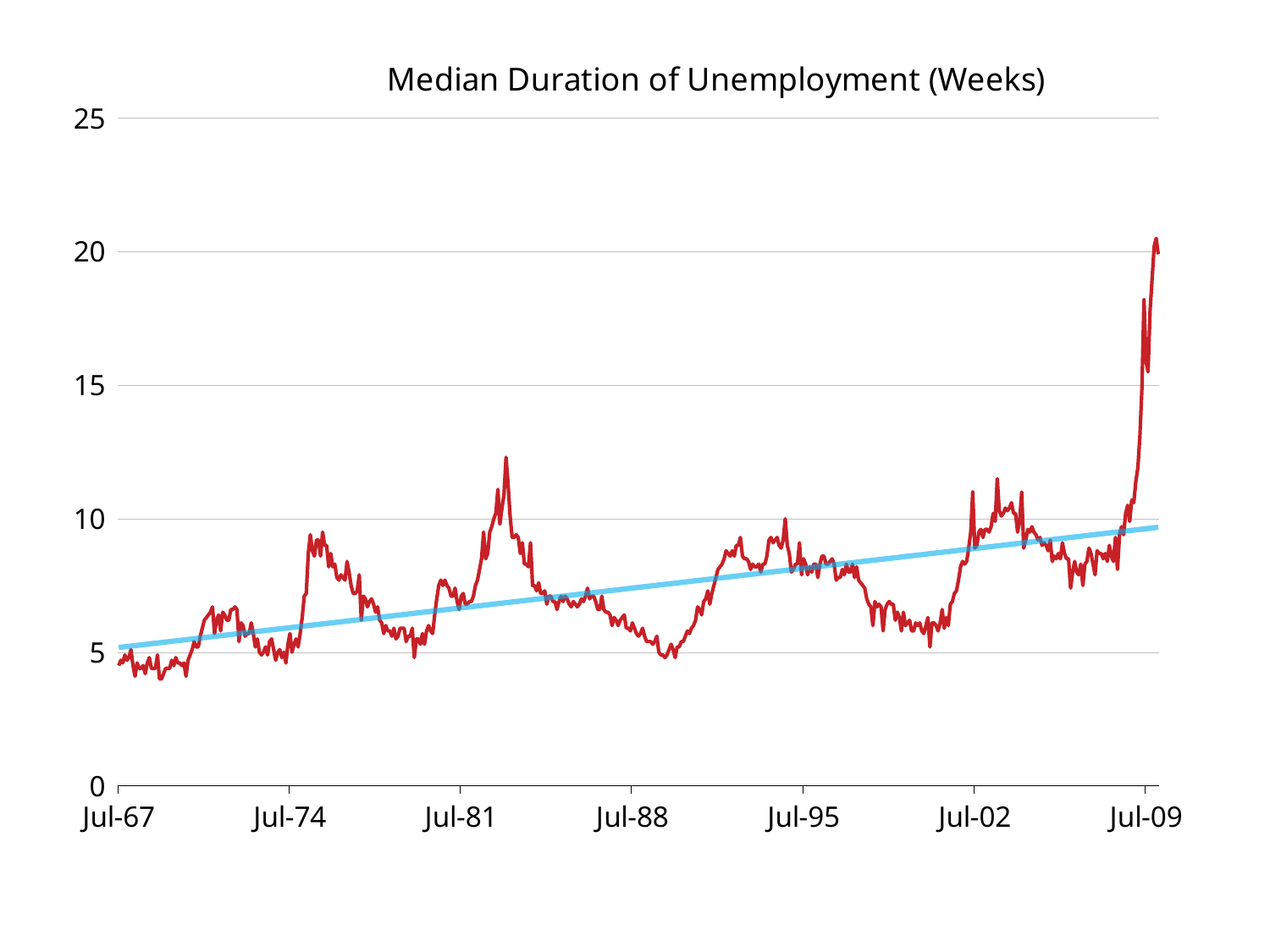
Does the straight blue trend line rise or fall from left to right? rise Near which x-axis label does the red line reach its highest value? Jul-09 Is the value of the red line at Jul-67 greater or less than 5? less Is the value of the red line at Jul-95 greater or less than 5? greater What colour is the straight trend line? blue Is the value of the red line at Jul-88 greater or less than 10? less What kind of chart is shown on the slide? line chart How many lines are plotted on the chart? 2 How many date labels are shown on the x axis? 7 What is the title of the chart? Median Duration of Unemployment (Weeks)